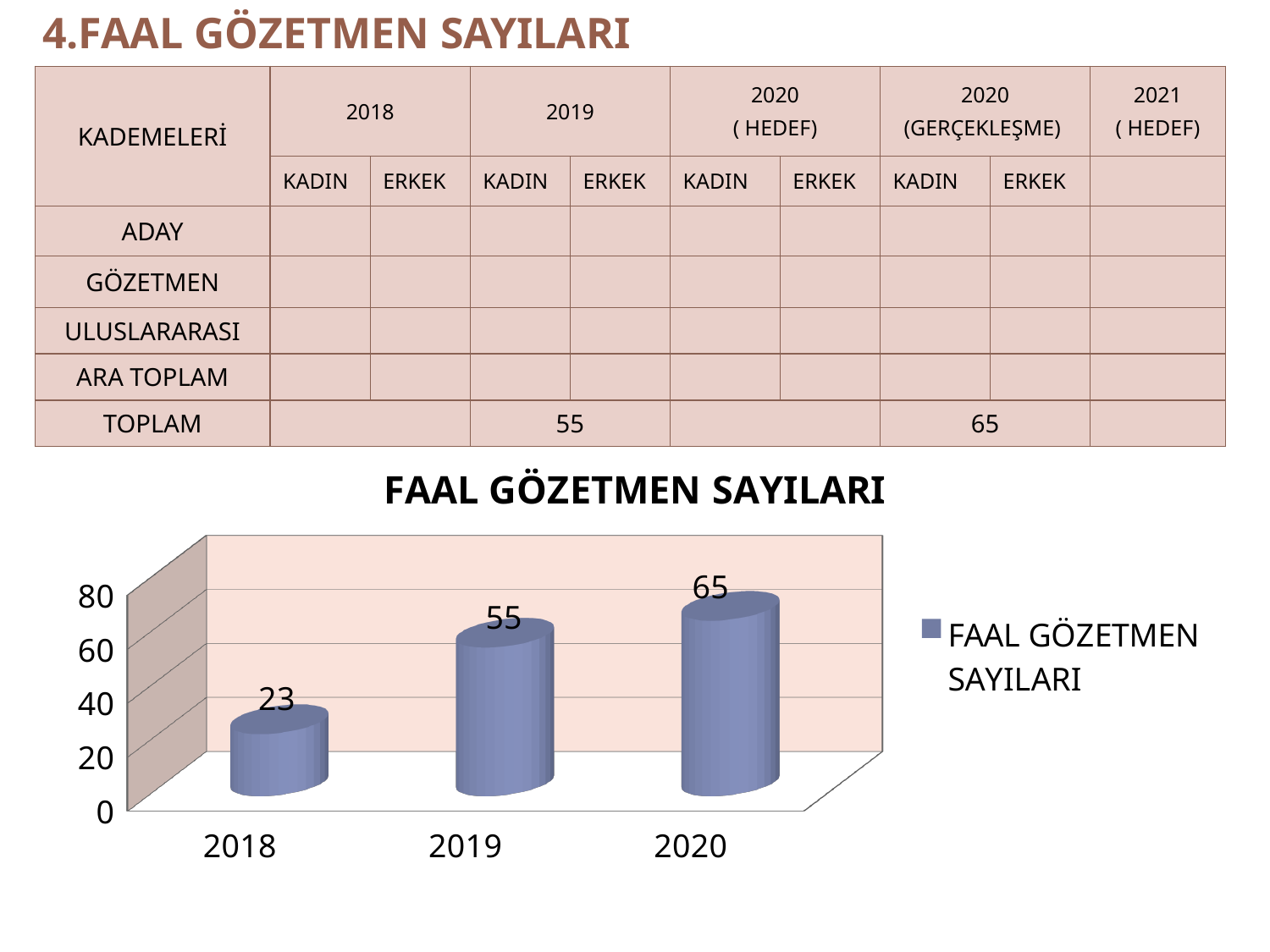
Which year has the highest value in the chart? 2020 What kind of chart is shown on the slide? bar chart What is the difference between the values for 2020 and 2019? 10 What is the difference between the values for 2019 and 2018? 32 Is the value for 2020 greater or less than 60? greater How many years are shown on the x axis of the chart? 3 What is the value for 2020 in the FAAL GÖZETMEN SAYILARI chart? 65 What is the value for 2018 in the FAAL GÖZETMEN SAYILARI chart? 23 What is the value for 2019 in the FAAL GÖZETMEN SAYILARI chart? 55 Which is larger, the value for 2018 or the value for 2019? 2019 Do the values rise or fall from 2018 to 2020? rise Which year has the lowest value in the chart? 2018